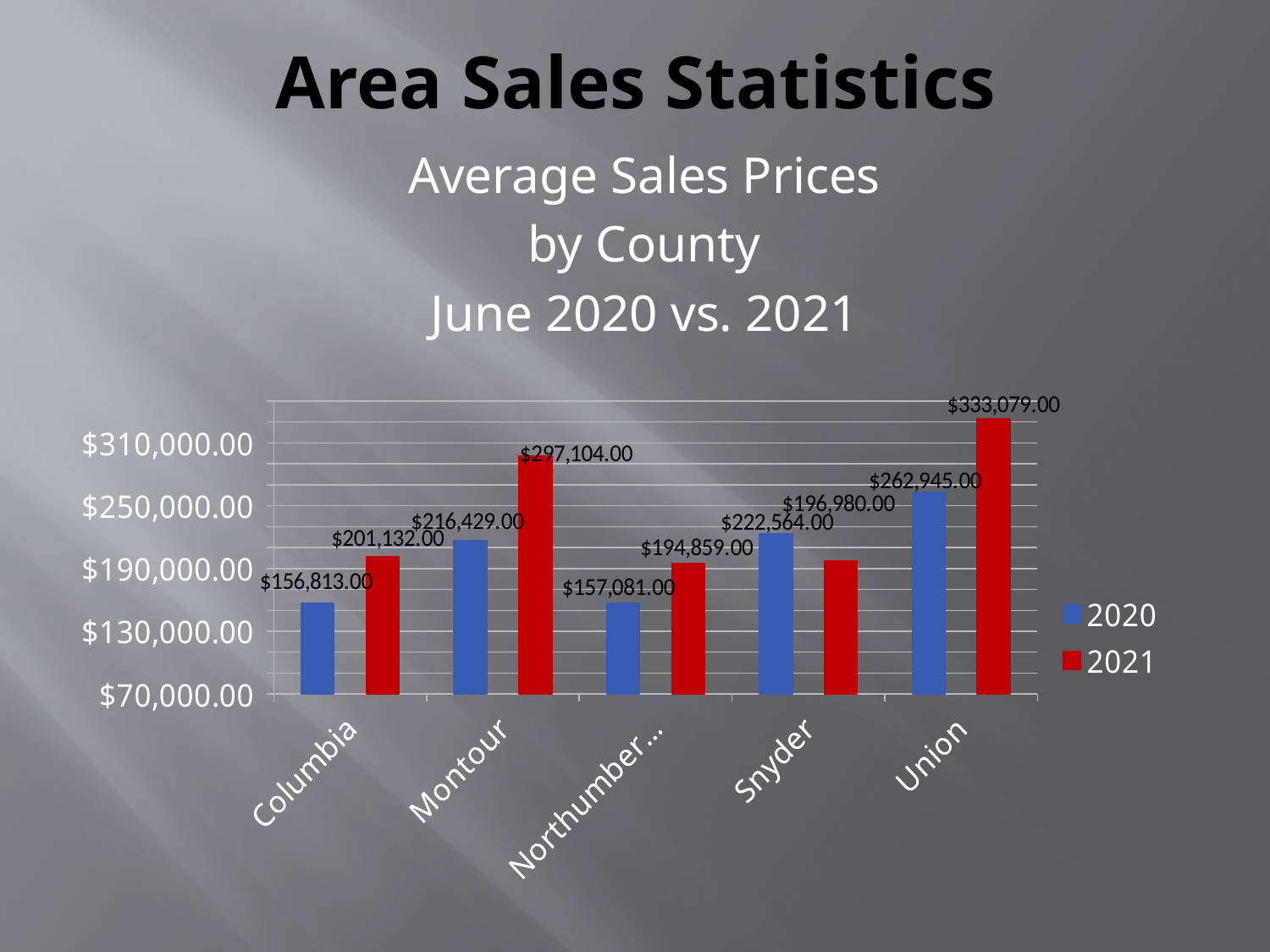
How many counties are shown on the chart? 5 What was the average sales price in Union for 2021? $333,079.00 In Snyder, which year had the higher average sales price, 2020 or 2021? 2020 What was the average sales price in Snyder for 2021? $196,980.00 What was the average sales price in Montour for 2020? $216,429.00 How many series does the legend list? 2 How much higher was Montour's average sales price in 2021 than in 2020? $80,675.00 What was the average sales price in Columbia for 2020? $156,813.00 Which county had the highest average sales price in 2020? Union Which county had the highest average sales price in 2021? Union What type of chart is shown on the slide? Bar chart How much higher was Union's average sales price in 2021 than in 2020? $70,134.00